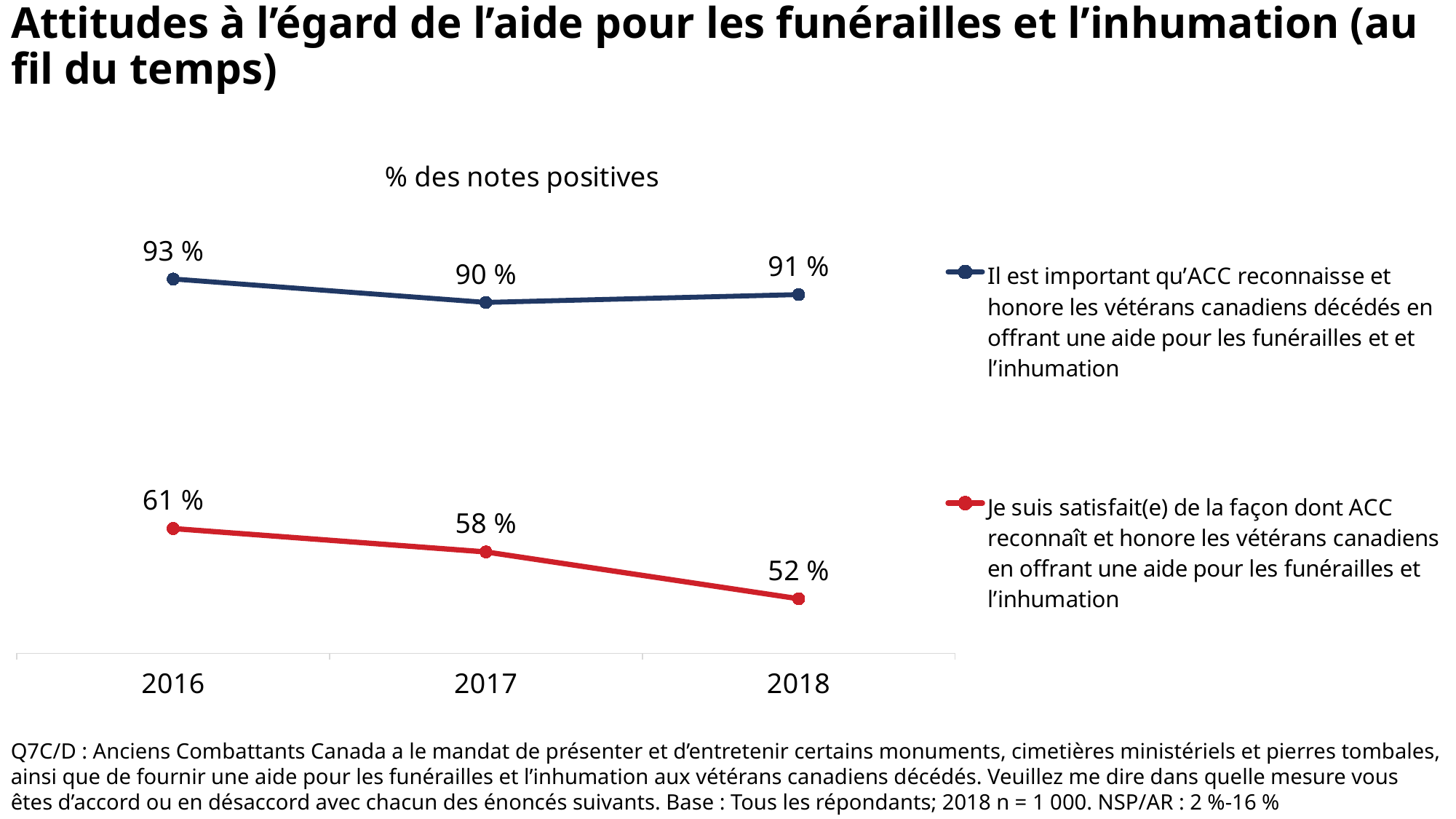
What is the value for 2017 for the series "Je suis satisfait(e) de la façon dont ACC reconnaît et honore les vétérans canadiens..."? 58 % How many series does the legend list? 2 In which year is the value for the series "Je suis satisfait(e)..." lowest? 2018 What is the value for 2018 for the series "Je suis satisfait(e) de la façon dont ACC reconnaît et honore les vétérans canadiens..."? 52 % What is the difference between the two series' values in 2018? 39 % In which year is the value for the series "Il est important qu'ACC reconnaisse..." highest? 2016 Does the value for the series "Je suis satisfait(e)..." rise or fall from 2016 to 2018? fall Which series has the higher value in 2017? Il est important qu'ACC reconnaisse et honore les vétérans canadiens décédés en offrant une aide pour les funérailles et et l'inhumation How many years are shown on the x axis? 3 What is the value for 2016 for the series "Il est important qu'ACC reconnaisse et honore les vétérans canadiens décédés..."? 93 % What type of chart is shown on the slide? line chart By how much did the value for the series "Je suis satisfait(e)..." change from 2016 to 2018? 9 %